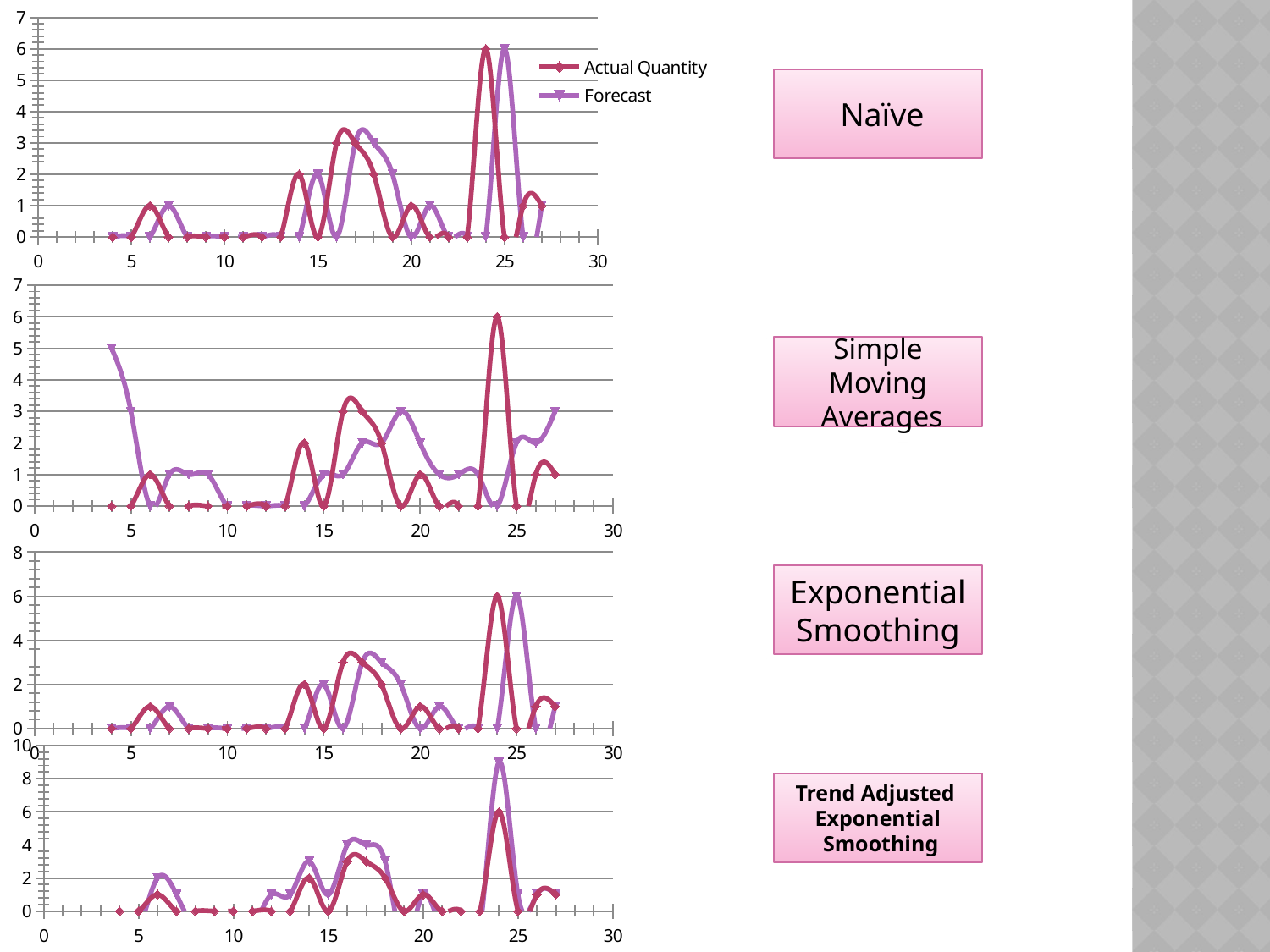
In the Simple Moving Averages chart, what is the Forecast value at x = 4? 5 In the Naïve chart, what is the highest value reached by Actual Quantity? 6 In the Trend Adjusted Exponential Smoothing chart, is the Forecast value at x = 24 greater or less than 8? greater In the Naïve chart, at which x value does Actual Quantity reach its highest point? 24 What is the highest value shown on the y axis of the Exponential Smoothing chart? 8 How many series does the legend of the Naïve chart list? 2 What are the two series named in the legend of the Naïve chart? Actual Quantity and Forecast What kind of chart is the top chart labelled Naïve? Line chart How many charts are shown on the slide? 4 In the Naïve chart, what is the Actual Quantity value at x = 14? 2 In the Trend Adjusted Exponential Smoothing chart, at x = 24, which is larger: Actual Quantity or Forecast? Forecast In the Simple Moving Averages chart, what is the Forecast value at x = 19? 3